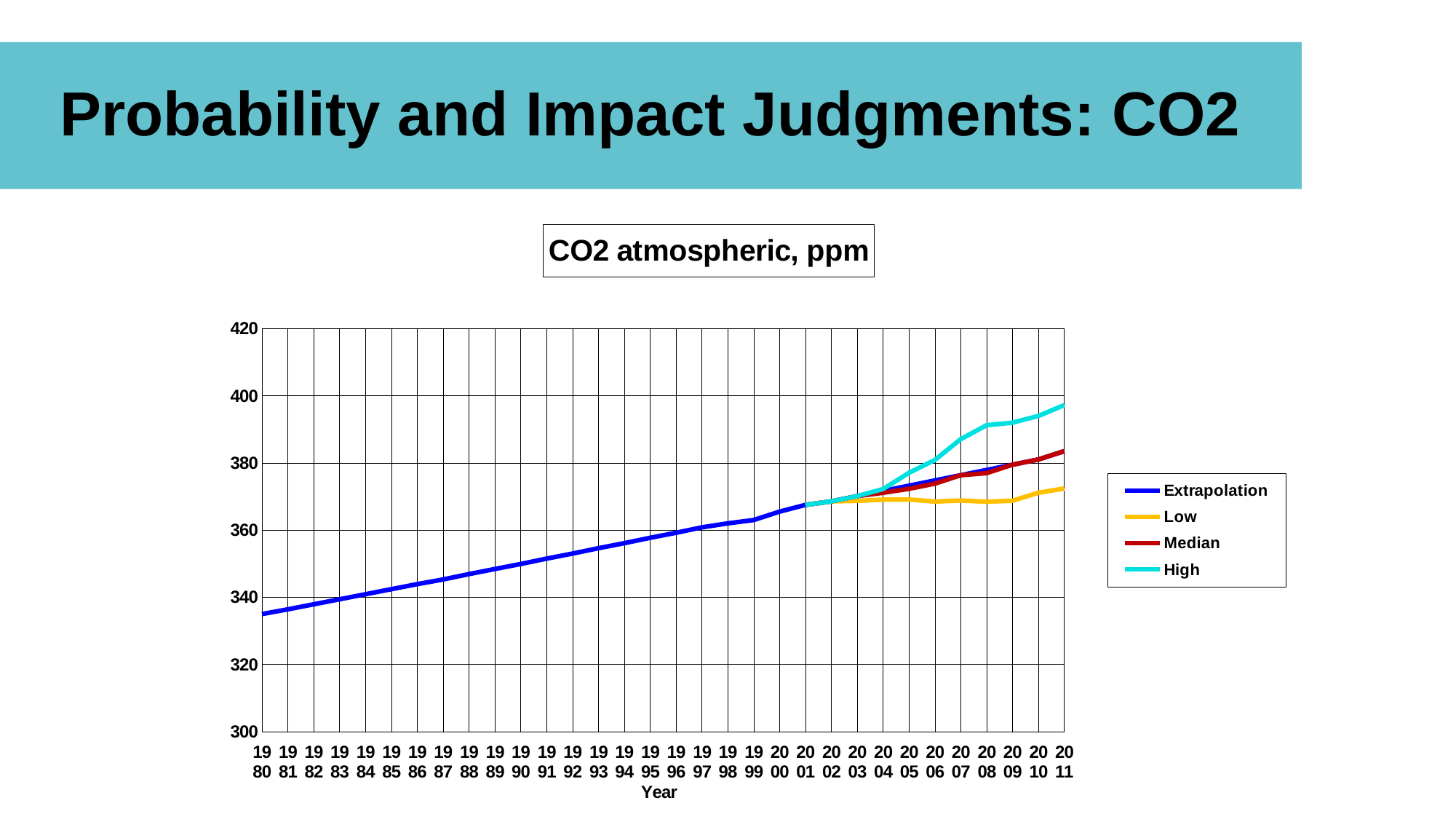
What kind of chart is shown on the slide? line chart How many years are shown along the x axis? 32 Is the value of the High series in 2011 greater or less than 380? greater Which series has the lowest value in 2011? Low How many series does the legend list? 4 What is the label of the x axis? Year In 2011, which is larger: the High series or the Median series? High What is the title of the chart? CO2 atmospheric, ppm Is the value of the Low series in 2011 greater or less than 380? less Does the Extrapolation series rise or fall from 1980 to 2001? rise Is the value of the Extrapolation series in 1980 greater or less than 340? less Which series has the highest value in 2011? High